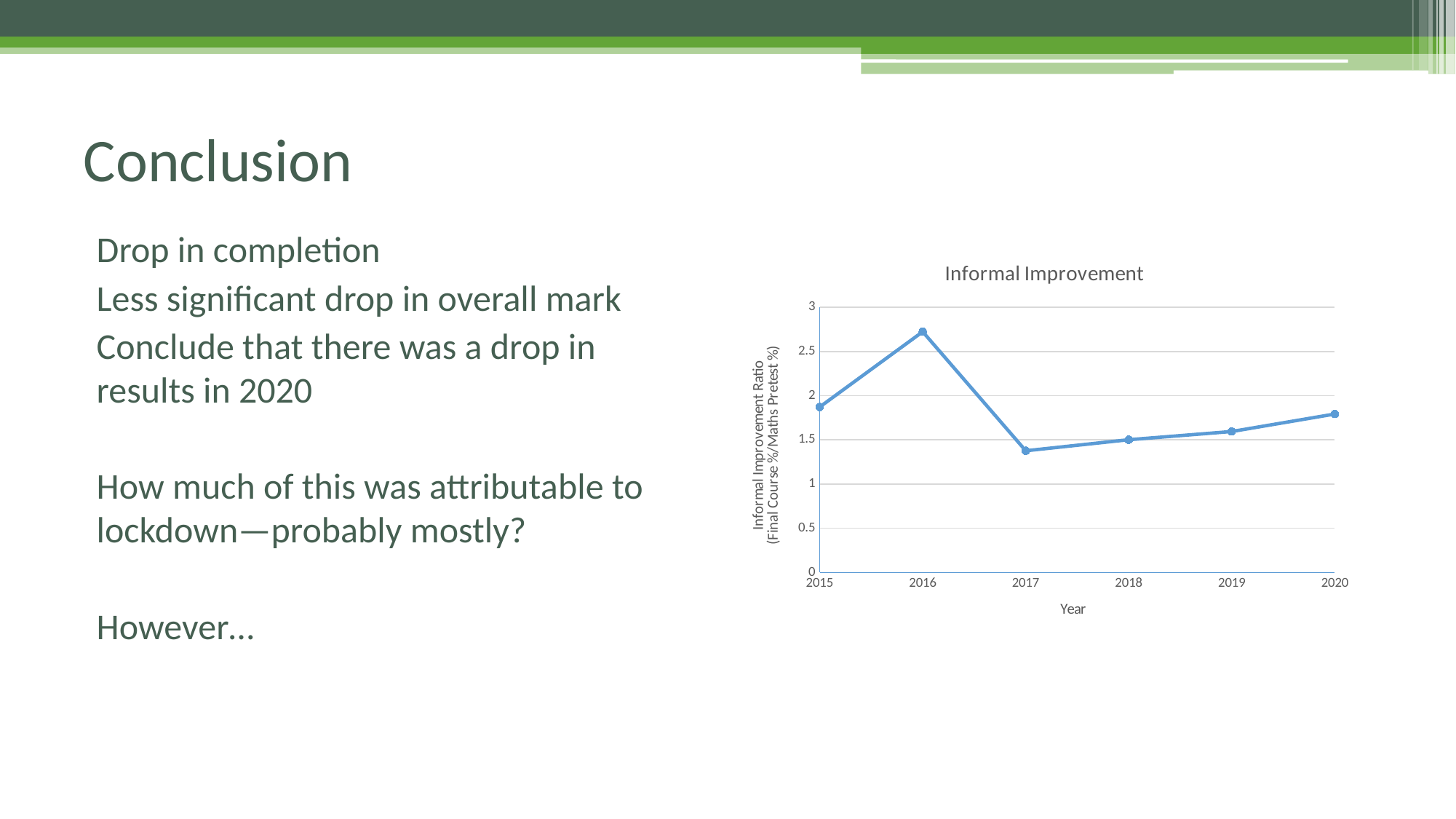
What kind of chart is shown on the slide? Line chart Is the value for 2016 greater or less than 2.5? greater Is the value for 2020 greater or less than 2? less Which year has the highest Informal Improvement Ratio? 2016 How many years are plotted on the chart? 6 Is the value for 2017 greater or less than 1.5? less Do the values rise or fall from 2017 to 2020? rise What is the title of the chart? Informal Improvement Which year has the larger value, 2015 or 2016? 2016 Which year has the larger value, 2017 or 2020? 2020 Which year has the lowest Informal Improvement Ratio? 2017